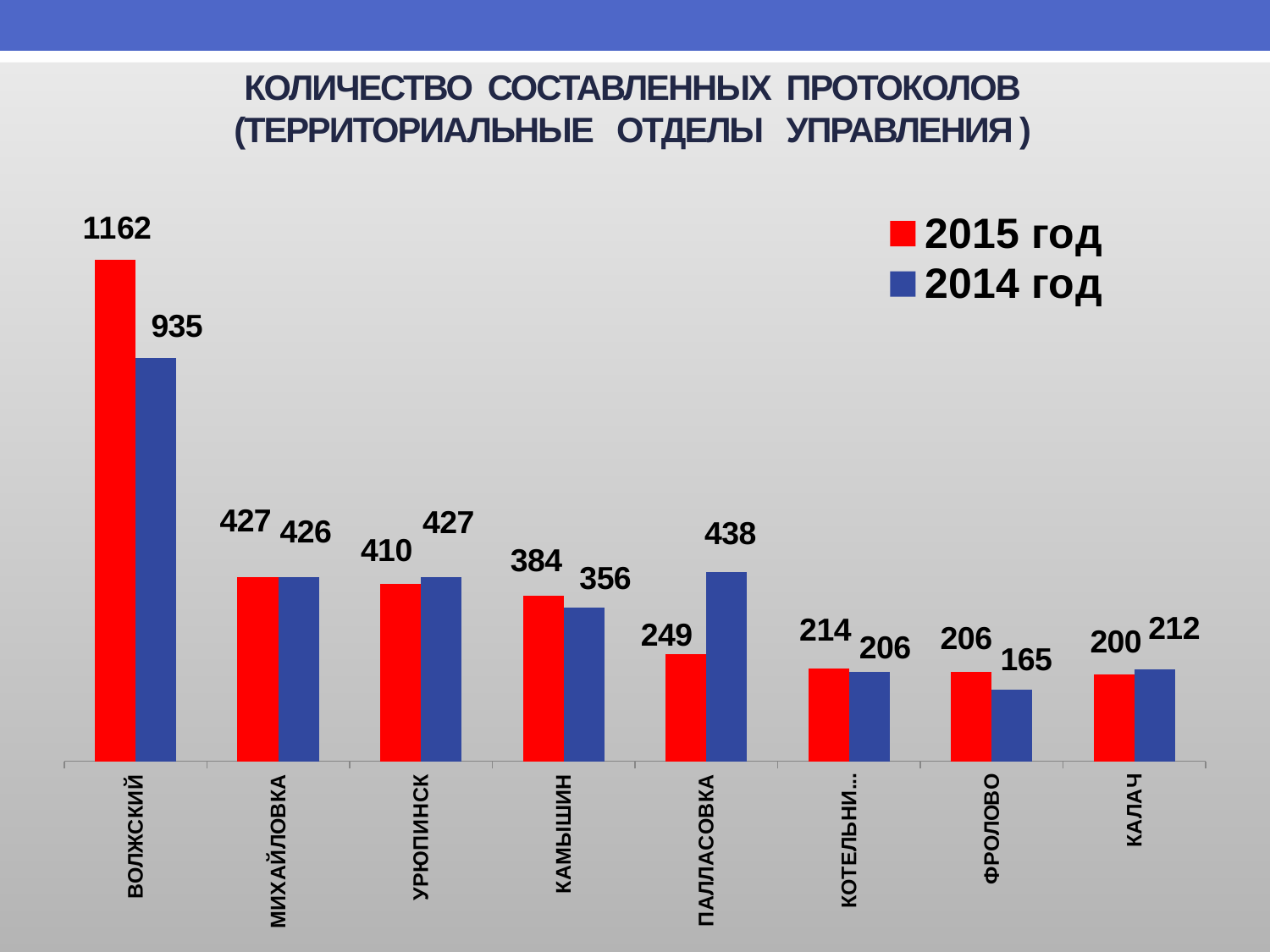
Which is larger for КАМЫШИН: the 2015 год value or the 2014 год value? 2015 год How many series does the legend list? 2 What kind of chart is shown on the slide? bar chart Which category has the highest value in the 2015 год series? ВОЛЖСКИЙ What is the difference between the 2014 год and 2015 год values for ПАЛЛАСОВКА? 189 How many categories are shown on the x axis? 8 What is the difference between the 2015 год and 2014 год values for ВОЛЖСКИЙ? 227 Which category has the lowest value in the 2014 год series? ФРОЛОВО What is the value for ПАЛЛАСОВКА in the 2014 год series? 438 Which is larger for КАЛАЧ: the 2015 год value or the 2014 год value? 2014 год What is the value for ВОЛЖСКИЙ in the 2015 год series? 1162 What is the value for ФРОЛОВО in the 2014 год series? 165